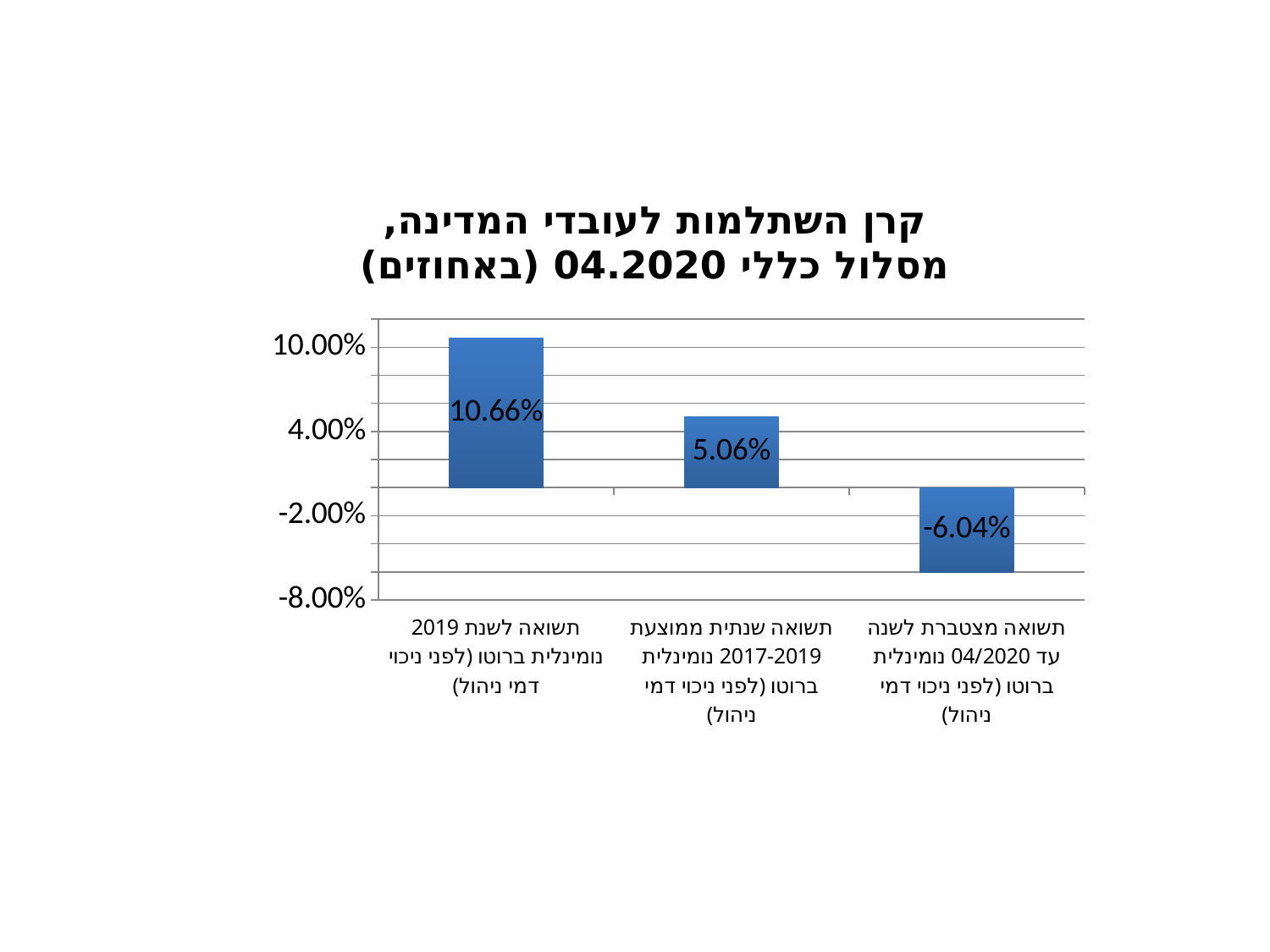
What is the value of the bar for 'תשואה לשנת 2019 נומינלית ברוטו (לפני ניכוי דמי ניהול)'? 10.66% What is the difference between the 2019 return (10.66%) and the 2017-2019 average annual return (5.06%)? 5.60% What is the value of the bar for 'תשואה מצטברת לשנה עד 04/2020 נומינלית ברוטו (לפני ניכוי דמי ניהול)'? -6.04% What kind of chart is shown on the slide? Bar chart Which is larger: the 2019 return or the 2017-2019 average annual return? The 2019 return (10.66%) What is the difference between the 2017-2019 average annual return (5.06%) and the cumulative return to 04/2020 (-6.04%)? 11.10% Which category has the lowest value? תשואה מצטברת לשנה עד 04/2020 נומינלית ברוטו (לפני ניכוי דמי ניהול) Is the value for the cumulative return to 04/2020 greater or less than -2.00%? less What is the value of the bar for 'תשואה שנתית ממוצעת 2017-2019 נומינלית ברוטו (לפני ניכוי דמי ניהול)'? 5.06% How many bars are shown in the chart? 3 Which category has the highest value? תשואה לשנת 2019 נומינלית ברוטו (לפני ניכוי דמי ניהול) What is the title of the chart? קרן השתלמות לעובדי המדינה, מסלול כללי 04.2020 (באחוזים)